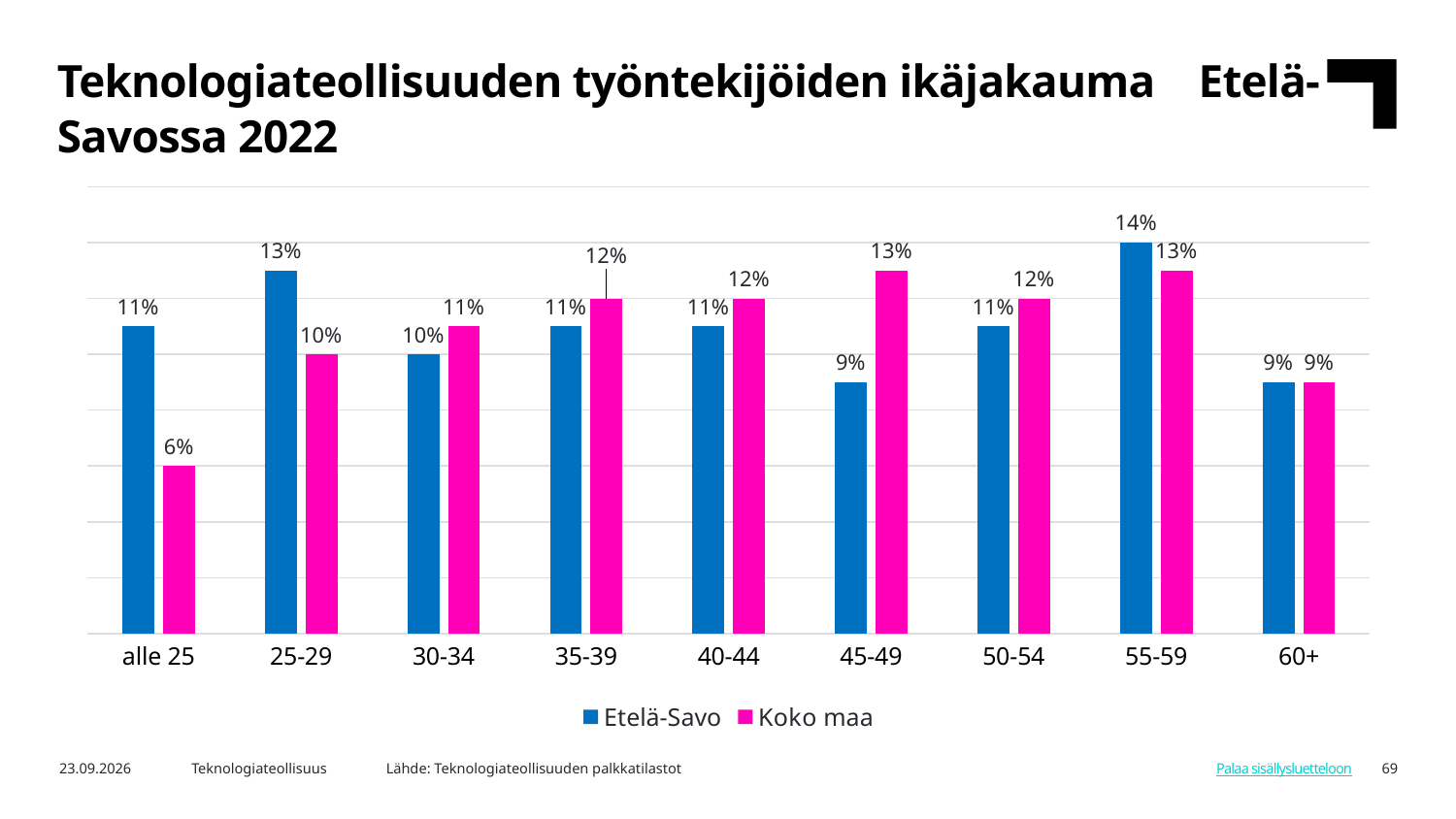
What kind of chart is shown on the slide? Bar chart Which age group has the lowest Koko maa value? alle 25 How many age groups are shown on the x axis? 9 For the 30-34 age group, which series has the larger value, Etelä-Savo or Koko maa? Koko maa What is the Koko maa value for the alle 25 age group? 6% Which age group has the highest Etelä-Savo value? 55-59 For the 25-29 age group, which series has the larger value, Etelä-Savo or Koko maa? Etelä-Savo What is the Koko maa value for the 45-49 age group? 13% What is the Etelä-Savo value for the 25-29 age group? 13% What is the difference between the Etelä-Savo and Koko maa values for the alle 25 age group? 5 percentage points How many series does the legend list? 2 What is the difference between the Koko maa and Etelä-Savo values for the 45-49 age group? 4 percentage points